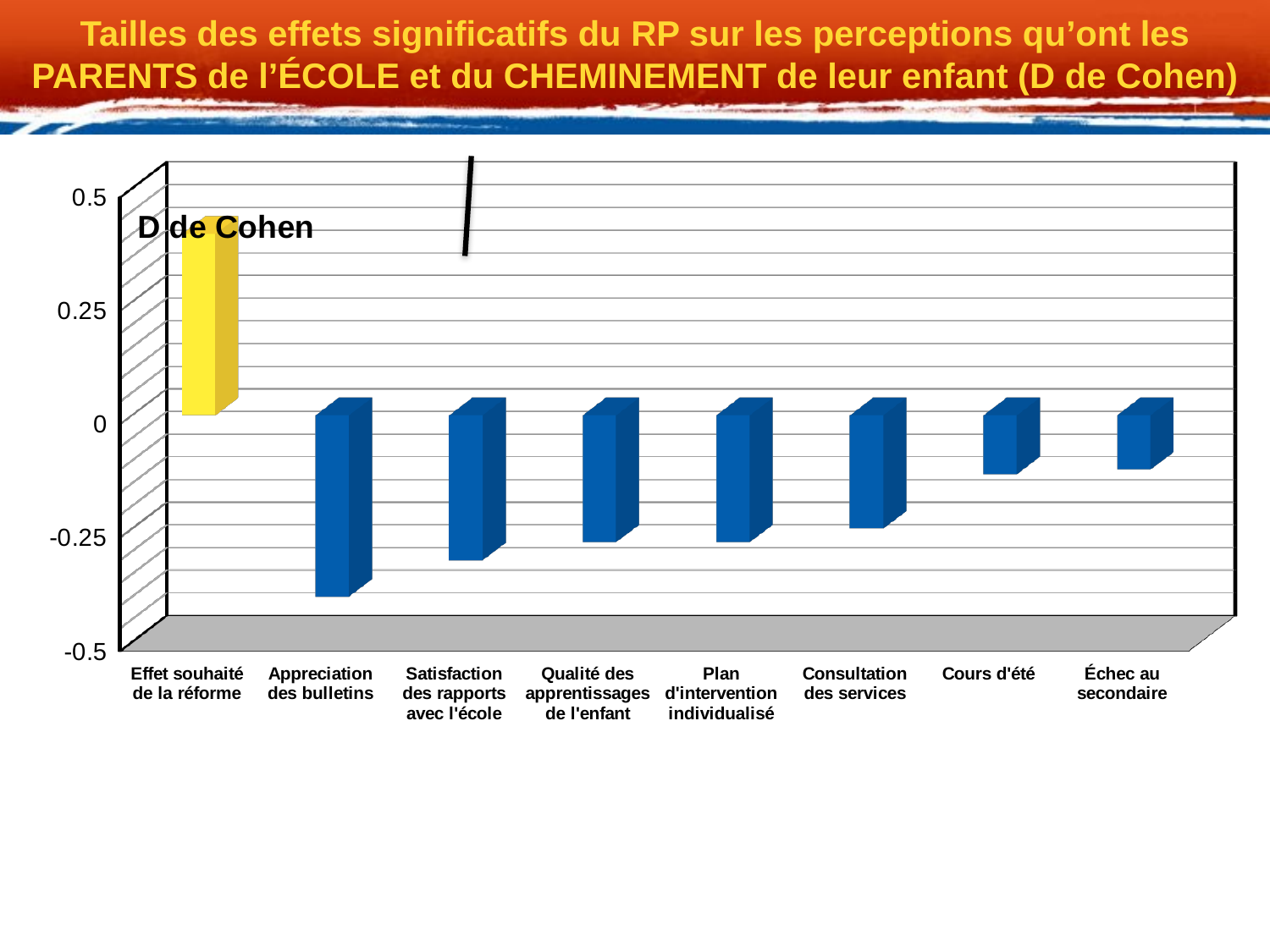
How many categories are shown on the x axis of the chart? 8 Is the value for Effet souhaité de la réforme greater or less than 0.25? greater Among the negative bars, do the values rise or fall from Appreciation des bulletins to Échec au secondaire? rise How many categories in the chart have a negative value? 7 Which category has the highest value in the chart? Effet souhaité de la réforme Which category has the lowest value in the chart? Appreciation des bulletins Is the value for Appreciation des bulletins greater or less than -0.25? less Is the value for Cours d'été greater or less than -0.25? greater Which category's bar is coloured yellow rather than blue? Effet souhaité de la réforme What kind of chart is shown on the slide? bar chart Which has the larger value, Appreciation des bulletins or Cours d'été? Cours d'été